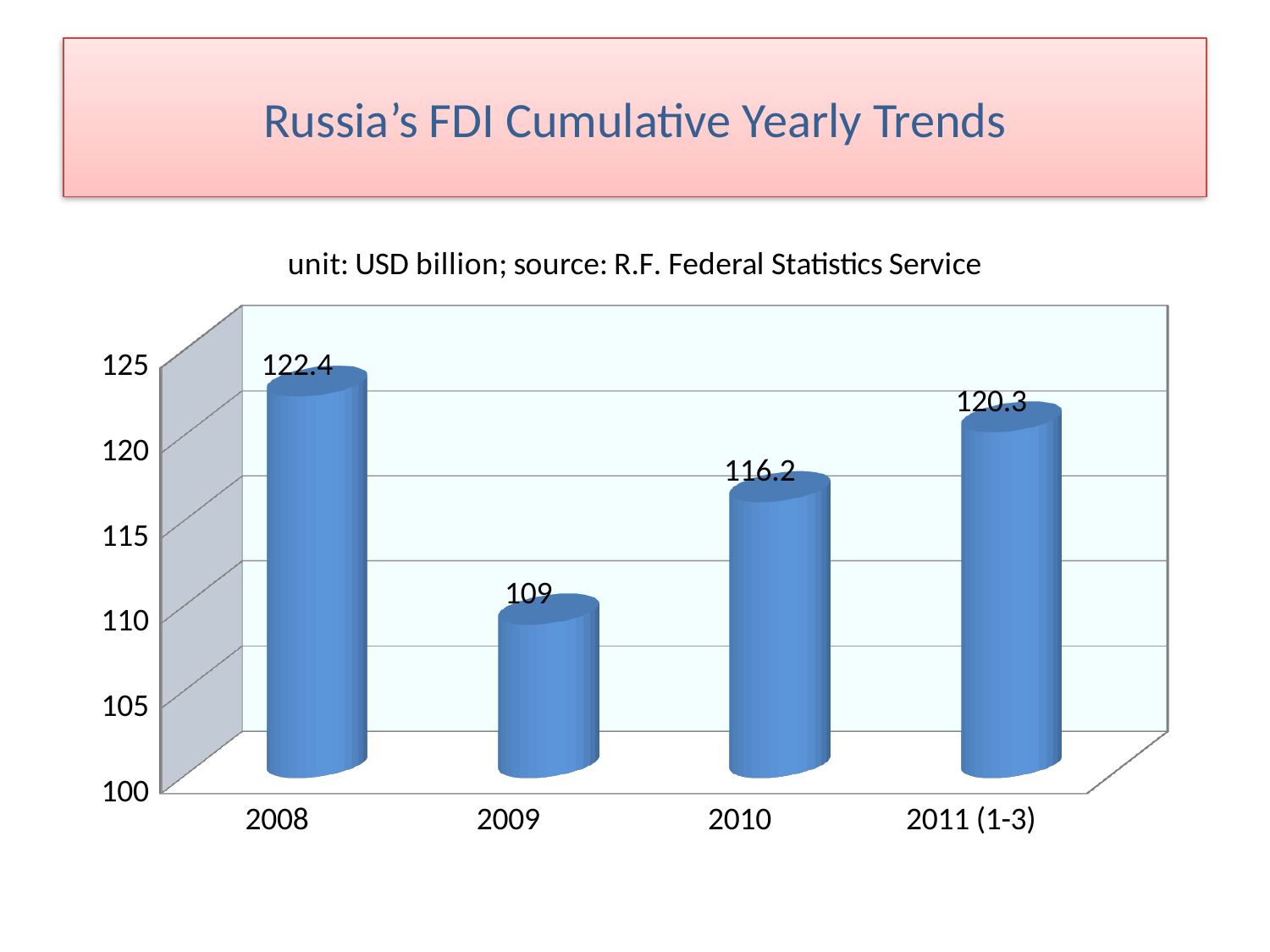
What is the value for 2011 (1-3)? 120.3 Which is larger, the value for 2010 or the value for 2011 (1-3)? 2011 (1-3) What is the difference between the values for 2008 and 2009? 13.4 What is the value for 2008? 122.4 Which year has the highest value? 2008 Which year has the lowest value? 2009 What kind of chart is shown on the slide? bar chart What is the value for 2009? 109 What is the value for 2010? 116.2 How many categories are shown on the x axis? 4 Is the value for 2010 greater or less than 115? greater What unit is stated for the values in the chart? USD billion